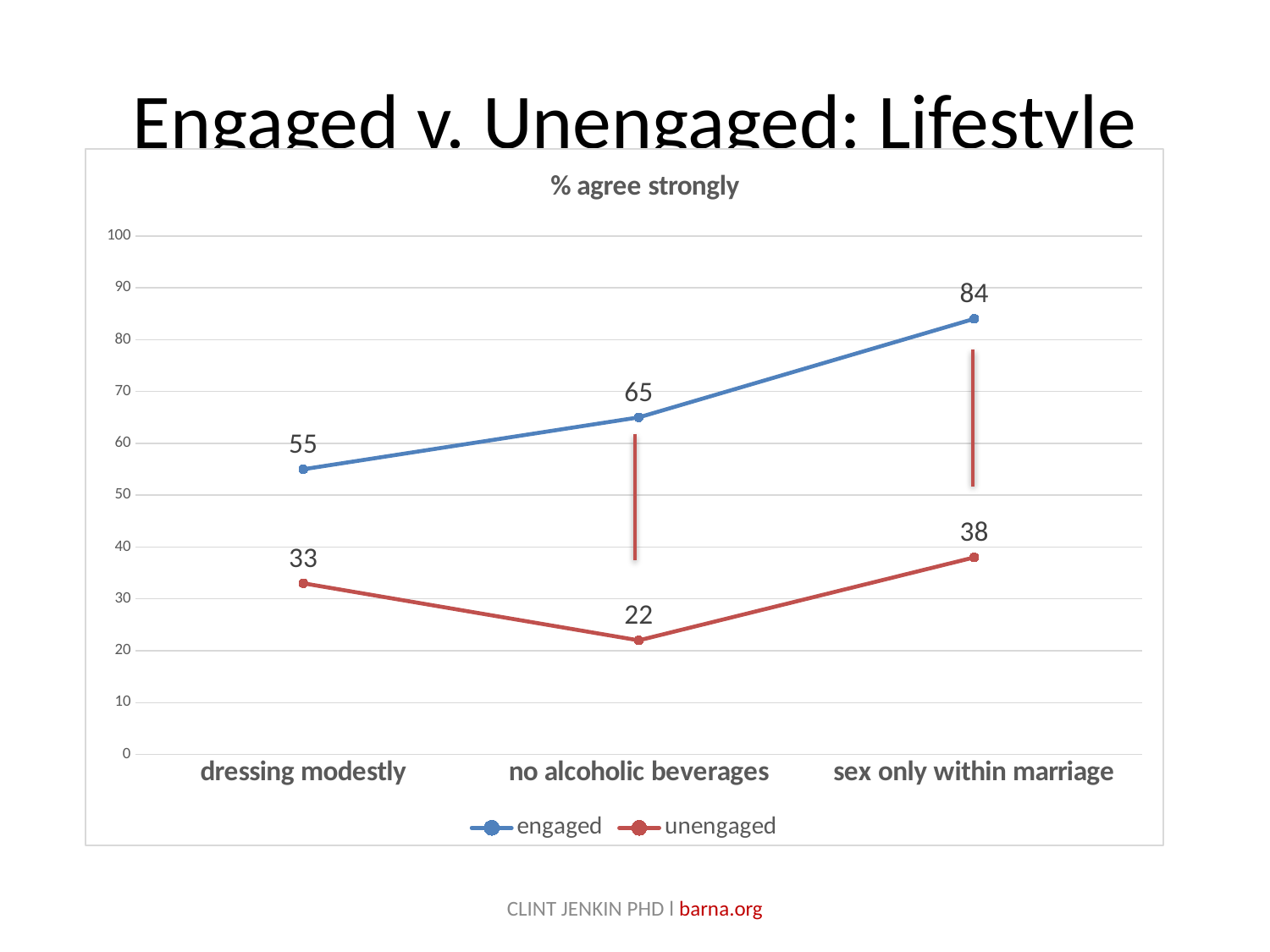
What is the difference between engaged and unengaged on sex only within marriage? 46 What kind of chart is shown? line chart What is the value for unengaged on no alcoholic beverages? 22 How many categories are shown on the x axis? 3 Which category has the highest value for the engaged series? sex only within marriage What is the value for unengaged on dressing modestly? 33 What is the value for engaged on dressing modestly? 55 How many series does the legend list? 2 What is the difference between engaged and unengaged on no alcoholic beverages? 43 Which category has the lowest value for the unengaged series? no alcoholic beverages What is the value for engaged on sex only within marriage? 84 Which is larger: the engaged value on dressing modestly or the unengaged value on sex only within marriage? engaged on dressing modestly